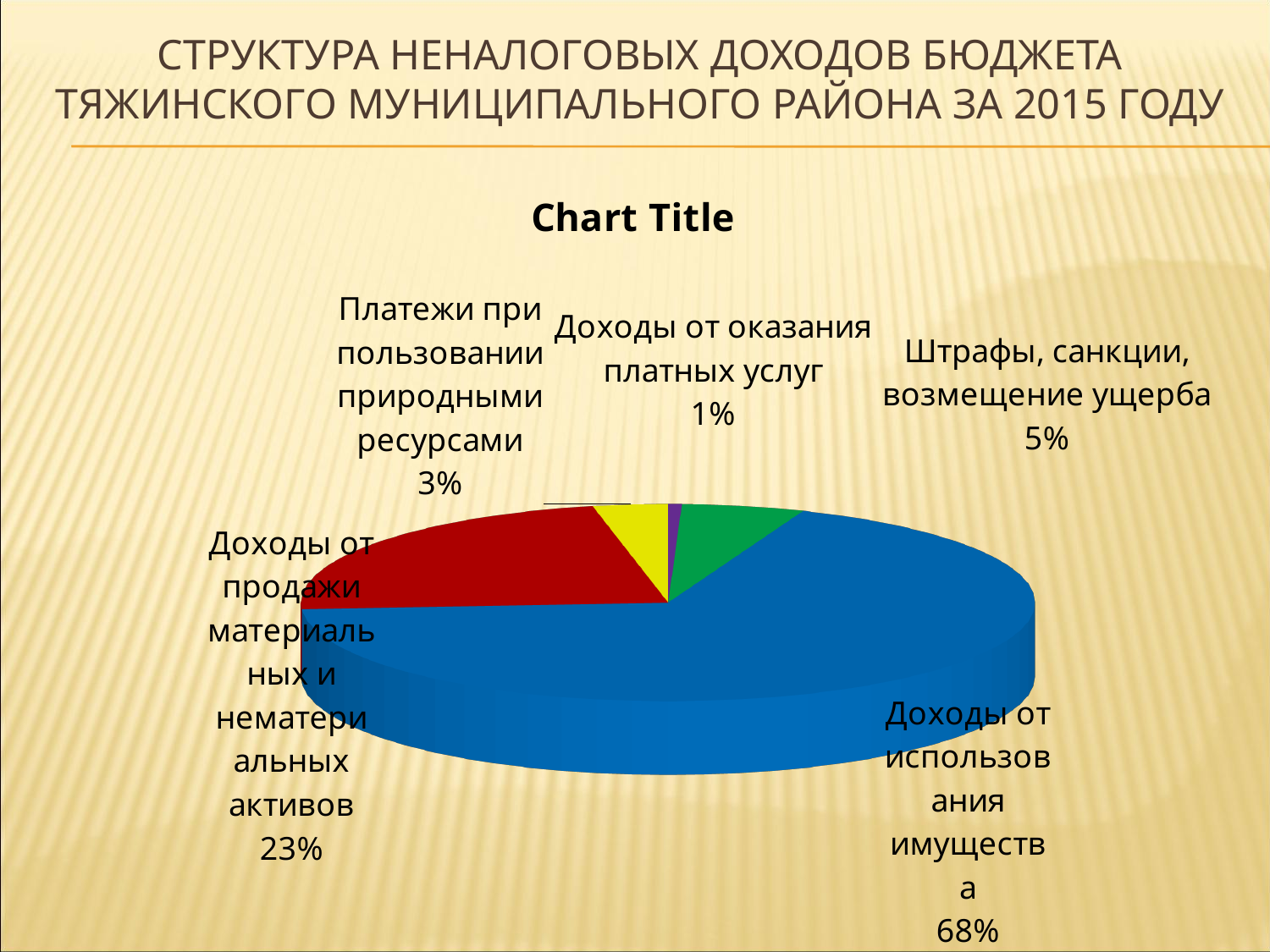
Which category has the smallest slice of the pie? Доходы от оказания платных услуг What share of the pie is "Платежи при пользовании природными ресурсами"? 3% What is the title printed above the pie chart? Chart Title What share of the pie is "Доходы от продажи материальных и нематериальных активов"? 23% What share of the pie is "Штрафы, санкции, возмещение ущерба"? 5% Which category has the largest slice of the pie? Доходы от использования имущества How many slices does the pie chart have? 5 What is the difference in percentage points between "Доходы от использования имущества" and "Доходы от продажи материальных и нематериальных активов"? 45 What kind of chart is shown on the slide? pie chart Which is larger: "Штрафы, санкции, возмещение ущерба" or "Платежи при пользовании природными ресурсами"? Штрафы, санкции, возмещение ущерба